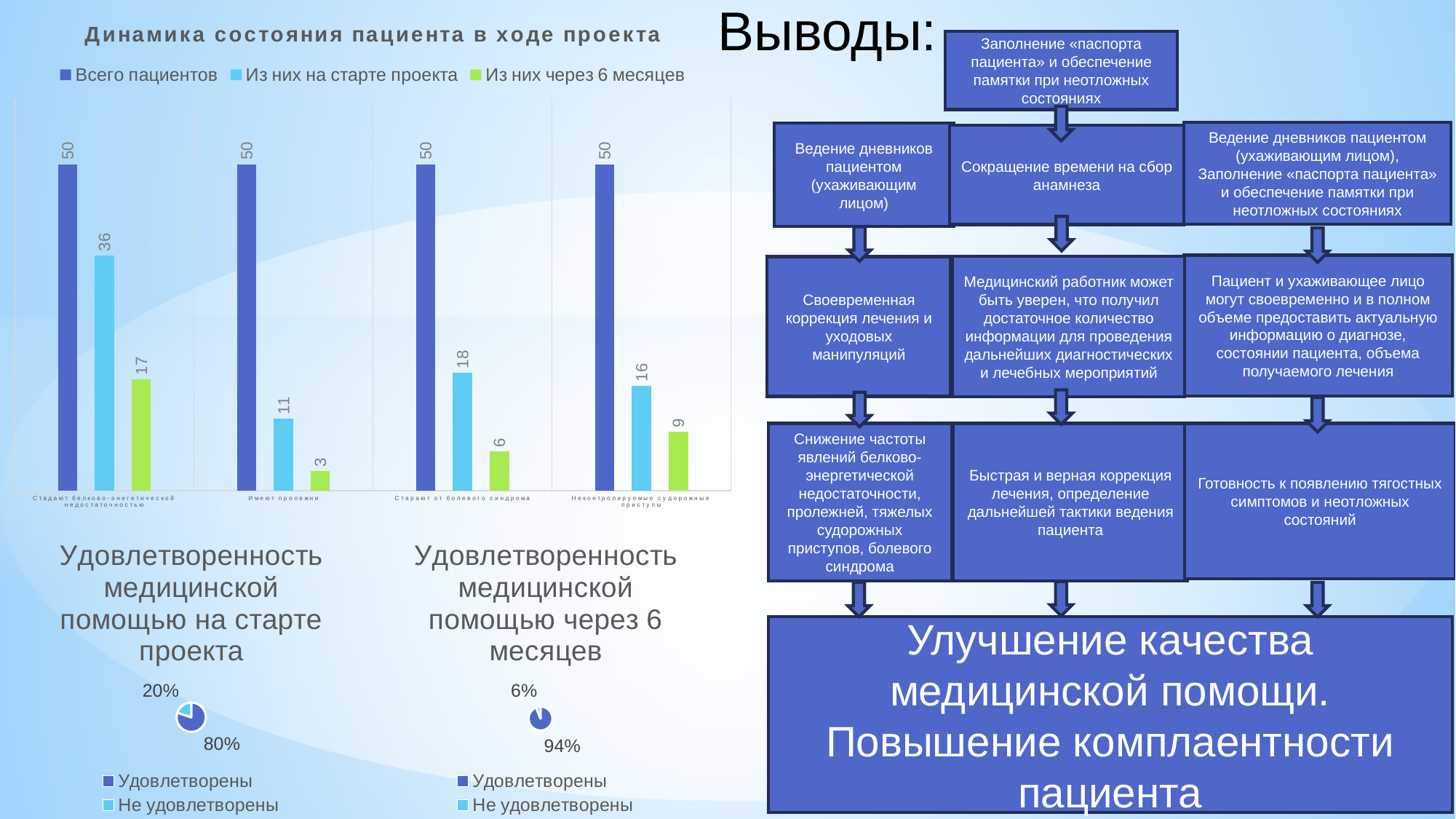
In the bar chart 'Динамика состояния пациента в ходе проекта', what is the value of 'Из них на старте проекта' for the category 'Имеют пролежни'? 11 What kind of chart is 'Динамика состояния пациента в ходе проекта'? Bar chart In the bar chart 'Динамика состояния пациента в ходе проекта', which category has the lowest value for the series 'Из них через 6 месяцев'? Имеют пролежни How many categories are shown on the x axis of the bar chart 'Динамика состояния пациента в ходе проекта'? 4 In the pie chart 'Удовлетворенность медицинской помощью через 6 месяцев', what share is 'Не удовлетворены'? 6% In the bar chart 'Динамика состояния пациента в ходе проекта', what is the value of 'Из них через 6 месяцев' for the category 'Страдают от болевого синдрома'? 6 In the pie chart 'Удовлетворенность медицинской помощью на старте проекта', what share is 'Удовлетворены'? 80% In the bar chart 'Динамика состояния пациента в ходе проекта', which category has the highest value for the series 'Из них на старте проекта'? Страдают белково-энергетической недостаточностью In the bar chart 'Динамика состояния пациента в ходе проекта', what is the value of 'Из них на старте проекта' for the category 'Неконтролируемые судорожные приступы'? 16 How many series does the legend of the bar chart 'Динамика состояния пациента в ходе проекта' list? 3 In the bar chart 'Динамика состояния пациента в ходе проекта', what is the difference between 'Из них на старте проекта' and 'Из них через 6 месяцев' for the category 'Страдают белково-энергетической недостаточностью'? 19 In the bar chart 'Динамика состояния пациента в ходе проекта', which is larger for the category 'Неконтролируемые судорожные приступы': 'Из них на старте проекта' or 'Из них через 6 месяцев'? Из них на старте проекта